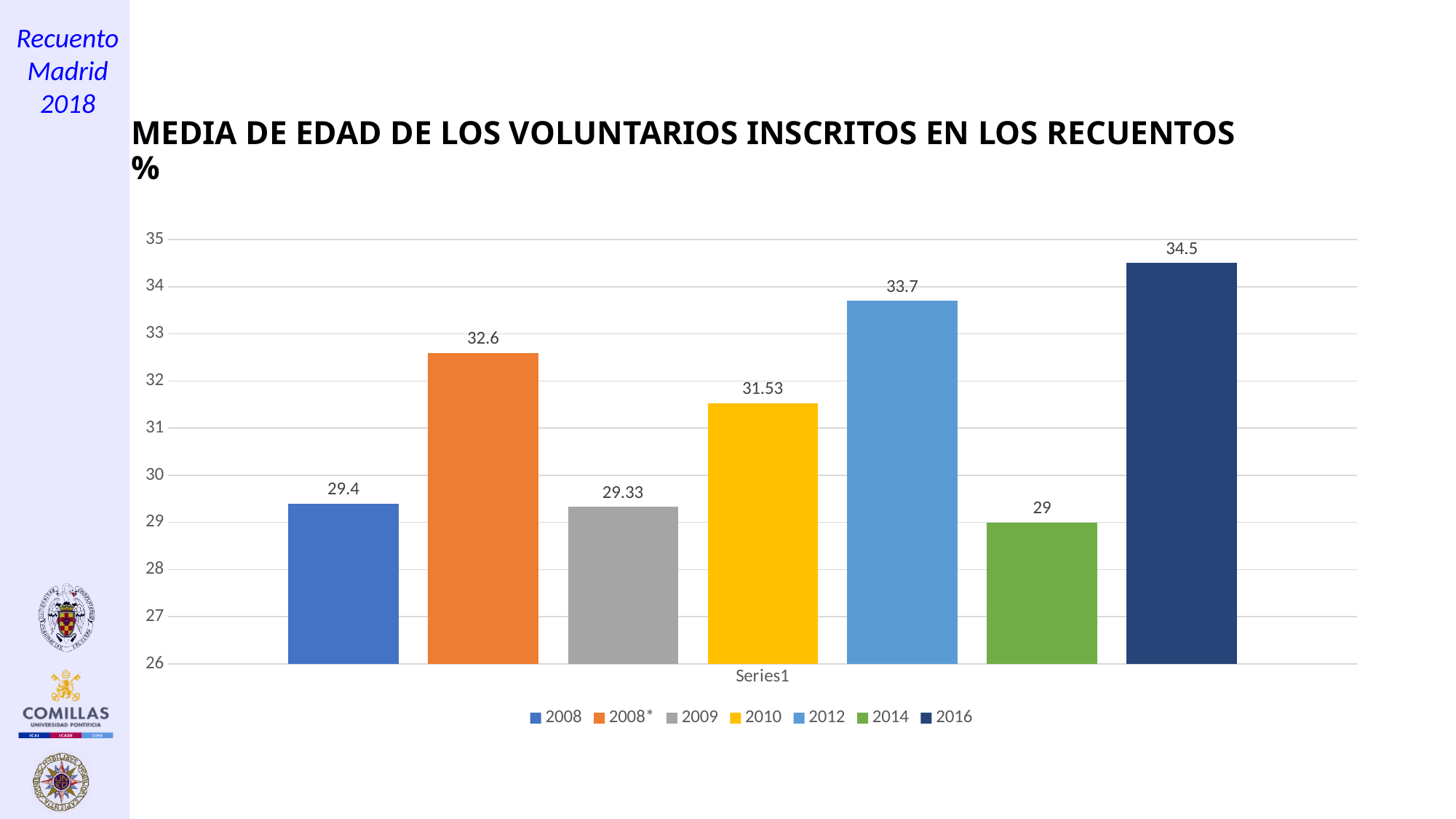
How many bars are shown in the chart? 7 What is the value for 2010? 31.53 Which is larger, the value for 2008* or the value for 2010? 2008* Which year has the highest value? 2016 What is the difference between the values for 2016 and 2014? 5.5 Is the value for 2012 greater or less than 33? greater Which year has the lowest value? 2014 What kind of chart is shown on the slide? Bar chart How many entries does the legend list? 7 What is the value for 2012? 33.7 What is the value for 2008? 29.4 What is the difference between the values for 2008* and 2009? 3.27